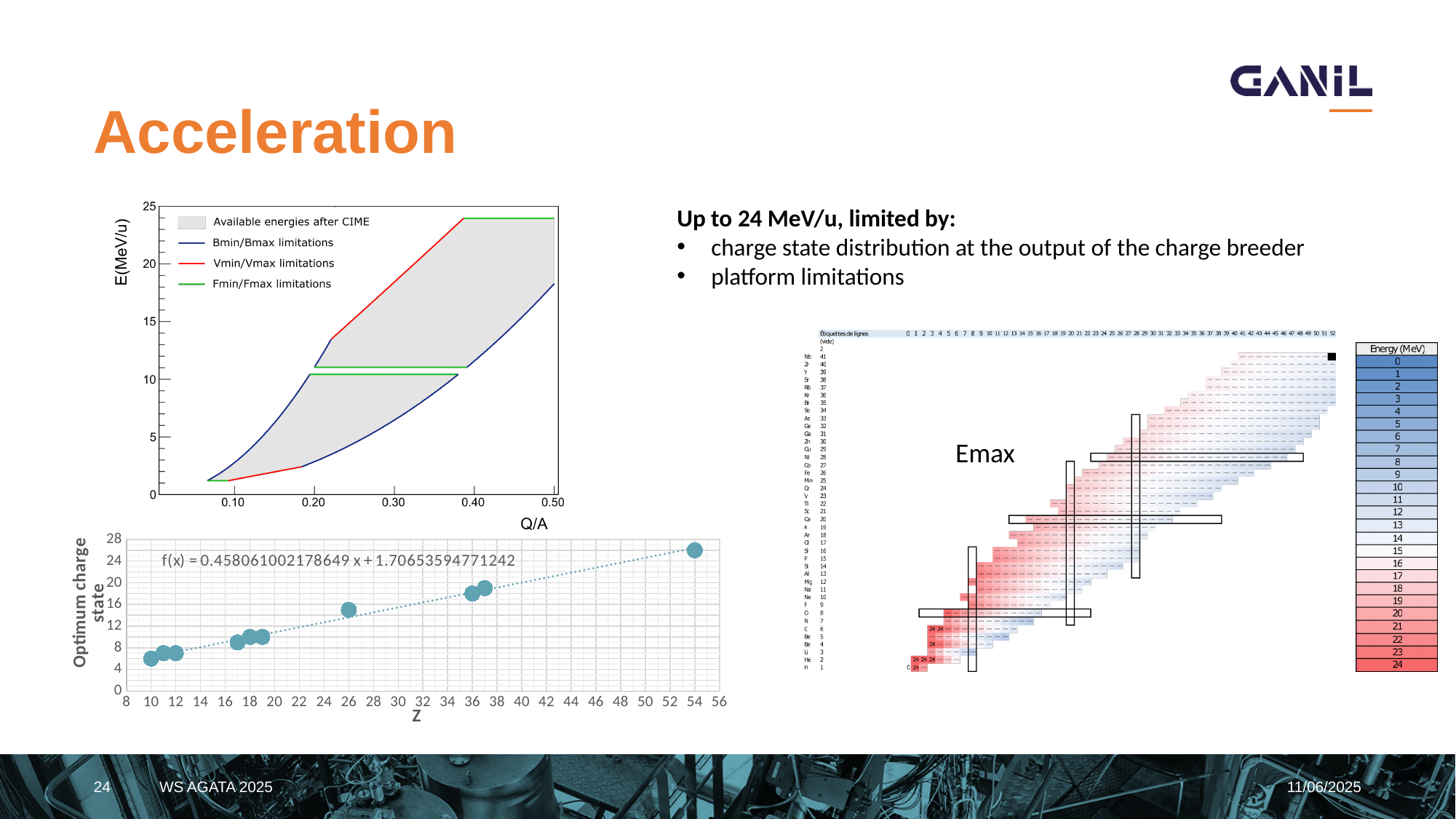
In the top-left chart, what is the label of the y axis? E(MeV/u) What kind of chart is the top-left chart showing E(MeV/u) against Q/A? line chart What kind of chart is the bottom-left chart of Optimum charge state against Z? scatter chart In the top-left chart, which colour is used for the Vmin/Vmax limitations line? red In the bottom-left scatter chart, does the optimum charge state rise or fall as Z increases? rise In the bottom-left scatter chart, what is the label of the x axis? Z In the bottom-left scatter chart, is the optimum charge state for Z = 10 greater or less than 8? less In the top-left chart, what is the highest value shown on the y axis? 25 In the top-left chart, how many entries does the legend list? 4 In the bottom-left scatter chart, is the optimum charge state for Z = 54 greater or less than 24? greater In the bottom-left scatter chart, is the optimum charge state for Z = 26 greater or less than 12? greater In the right-hand heatmap, what is the maximum value shown in the Energy (MeV) colour scale? 24